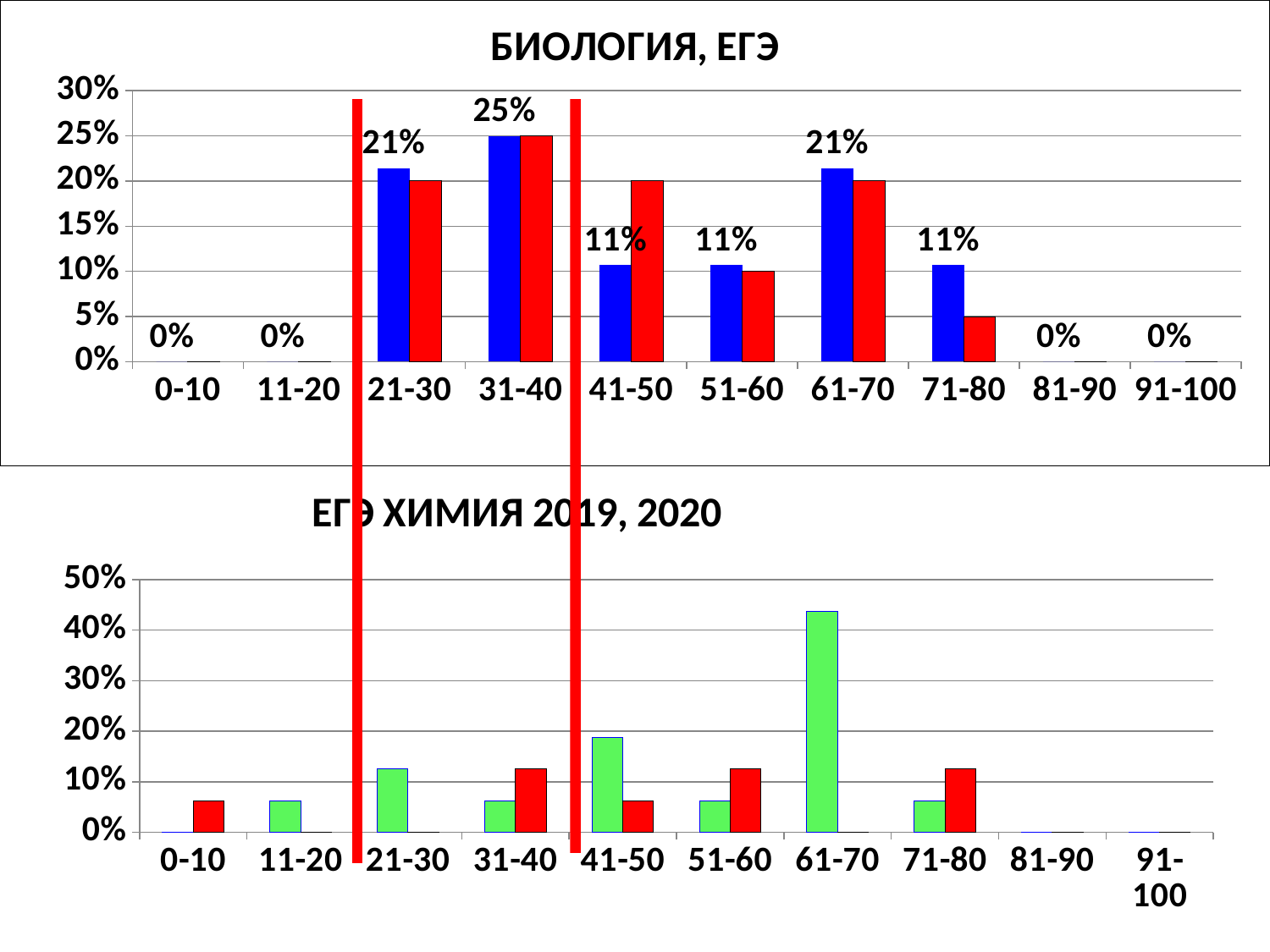
What kind of chart is the top chart titled "БИОЛОГИЯ, ЕГЭ"? bar chart In the top chart "БИОЛОГИЯ, ЕГЭ", what data label is shown for the 31-40 category? 25% In the top chart "БИОЛОГИЯ, ЕГЭ", what data label is shown for the 71-80 category? 11% In the top chart "БИОЛОГИЯ, ЕГЭ", what data label is shown for the 91-100 category? 0% In the top chart "БИОЛОГИЯ, ЕГЭ", is the red bar for 71-80 greater or less than 10%? less In the bottom chart "ЕГЭ ХИМИЯ 2019, 2020", which category has the tallest green bar? 61-70 In the top chart "БИОЛОГИЯ, ЕГЭ", what data label is shown for the 21-30 category? 21% In the top chart "БИОЛОГИЯ, ЕГЭ", which category has the highest labeled value? 31-40 In the bottom chart "ЕГЭ ХИМИЯ 2019, 2020", is the green bar for 61-70 greater or less than 40%? greater In the top chart "БИОЛОГИЯ, ЕГЭ", how many score-range categories are shown on the x axis? 10 In the top chart "БИОЛОГИЯ, ЕГЭ", which has the larger labeled value: 21-30 or 51-60? 21-30 In the top chart "БИОЛОГИЯ, ЕГЭ", what is the difference between the labeled values for 31-40 and 41-50? 14%